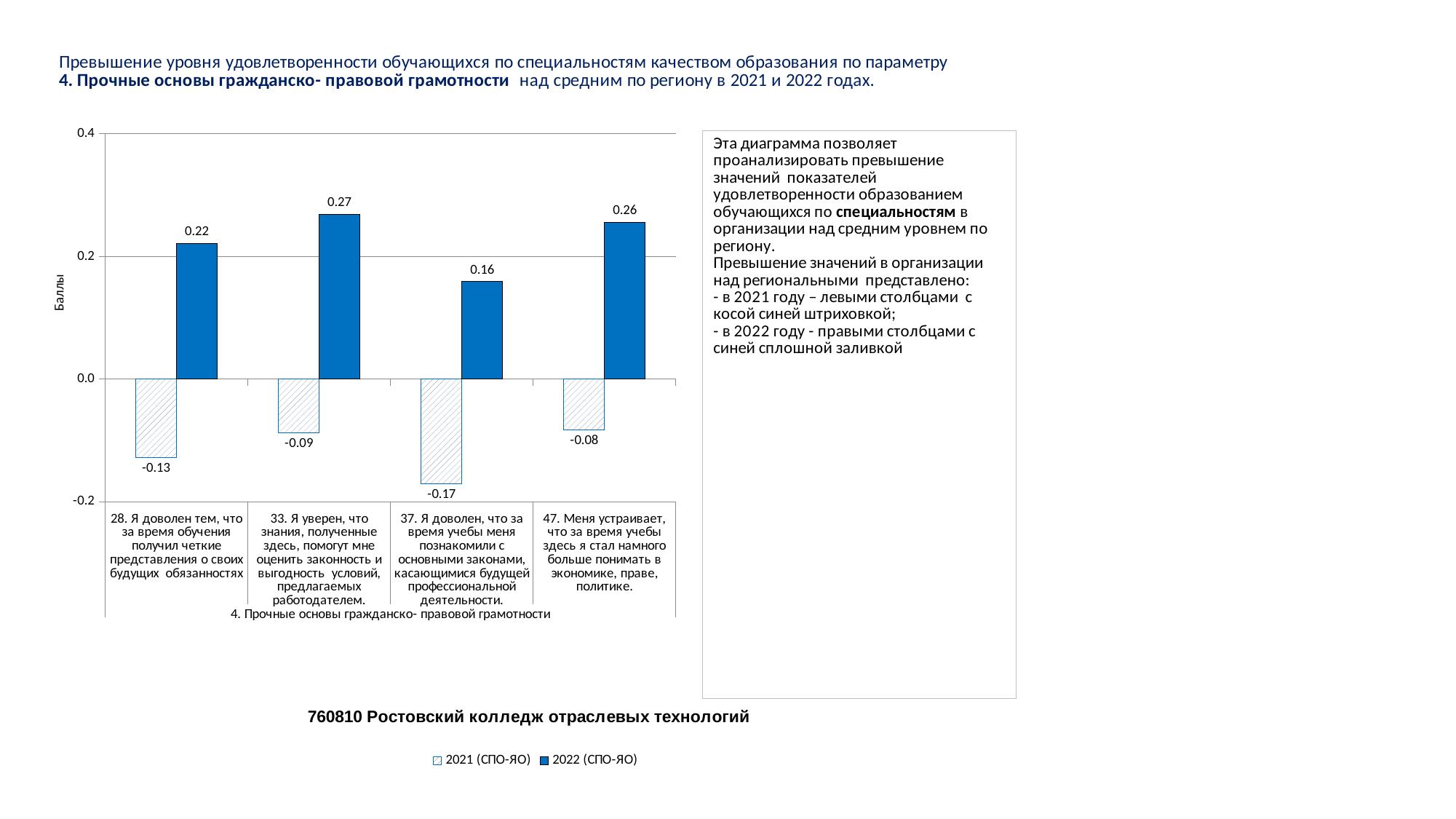
What kind of chart is shown on the slide? Bar chart What is the value for 2021 (СПО-ЯО) for category 37 (Я доволен, что за время учебы меня познакомили с основными законами, касающимися будущей профессиональной деятельности)? -0.17 Which category has the lowest value for the 2021 (СПО-ЯО) series? 37. Я доволен, что за время учебы меня познакомили с основными законами, касающимися будущей профессиональной деятельности. What is the value for 2022 (СПО-ЯО) for category 33 (Я уверен, что знания, полученные здесь, помогут мне оценить законность и выгодность условий, предлагаемых работодателем)? 0.27 Which is larger: the 2022 (СПО-ЯО) value for category 28 or for category 47? Category 47 (0.26) What is the difference between the 2022 (СПО-ЯО) and 2021 (СПО-ЯО) values for category 28? 0.35 Is the 2022 (СПО-ЯО) value for category 37 greater or less than 0.2? less What is the label of the vertical axis of the chart? Баллы How many series does the legend list? 2 Which category has the highest value for the 2022 (СПО-ЯО) series? 33. Я уверен, что знания, полученные здесь, помогут мне оценить законность и выгодность условий, предлагаемых работодателем. How many categories are shown on the x axis of the chart? 4 What is the value for 2021 (СПО-ЯО) for category 47 (Меня устраивает, что за время учебы здесь я стал намного больше понимать в экономике, праве, политике)? -0.08